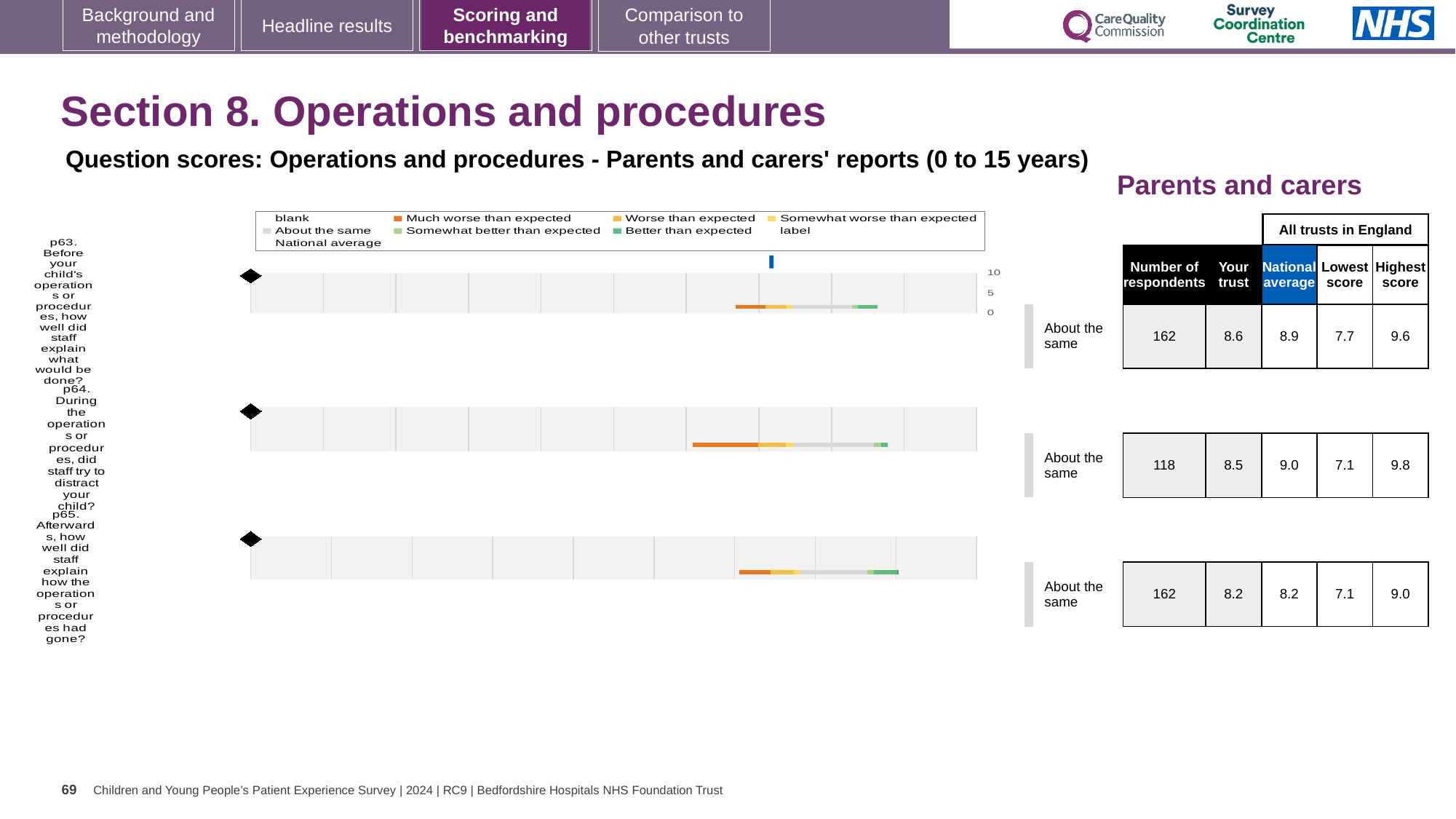
How many questions (rows) are plotted in the benchmarking chart? 3 What is the difference between the highest score (9.6) and the lowest score (7.7) for question p63? 1.9 What benchmark category label is shown next to each of the three questions? About the same What is the number of respondents for question p64? 118 What is the national average score for question p64 (did staff try to distract your child during the operation)? 9.0 For question p64, is the 'Your trust' score higher or lower than the national average? lower Which question has the highest 'Your trust' score? p63 What is the 'Your trust' score for question p63 (how well staff explained what would be done before the operation)? 8.6 Which question has the lowest national average score? p65 What is the highest score among all trusts in England for question p65 (how well staff explained how the operation had gone)? 9.0 What kind of chart is used to show the benchmarking results for each question? bar chart Which colour in the legend represents 'Much worse than expected'? orange